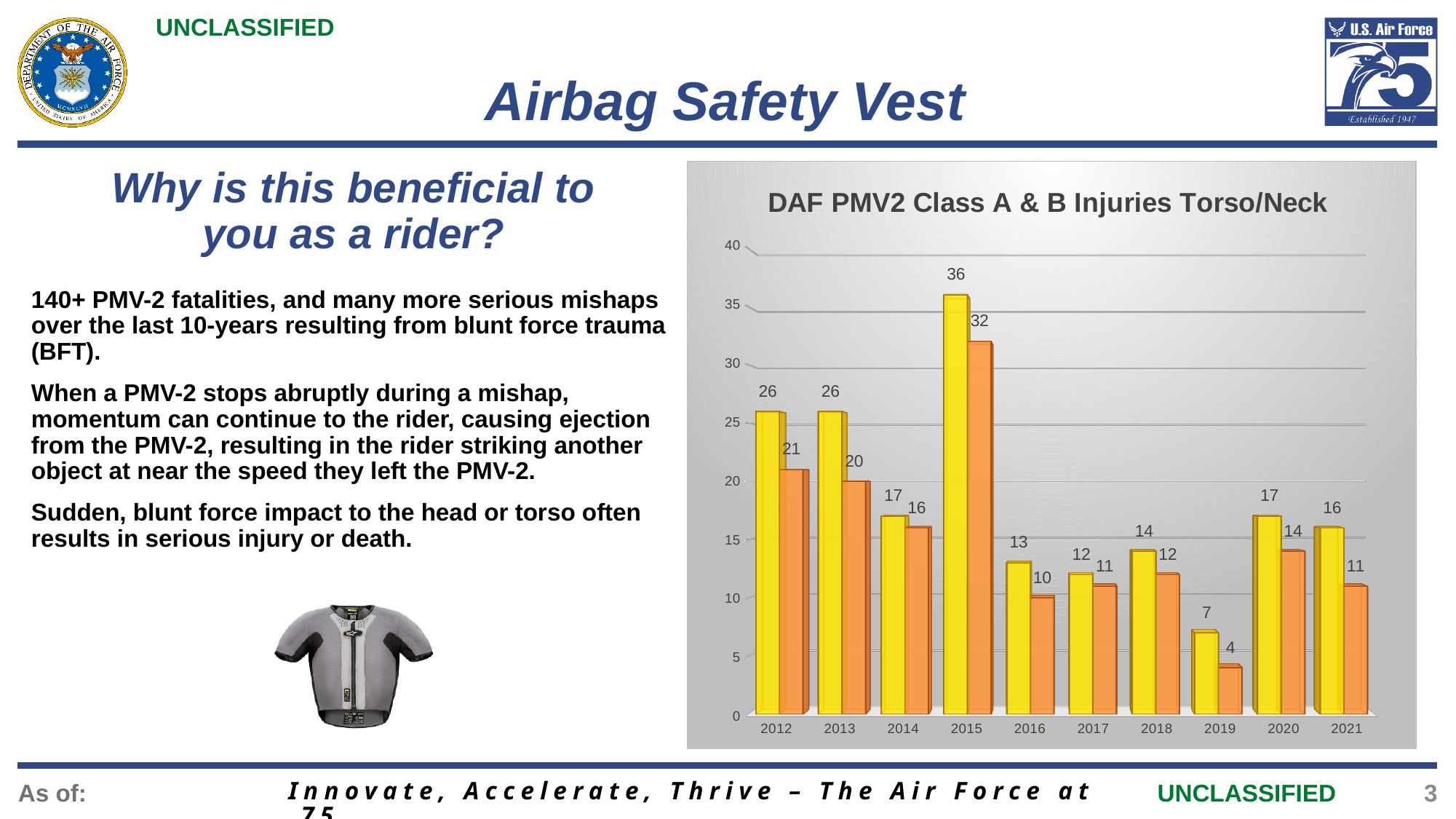
What kind of chart is shown on the slide? bar chart What is the difference between the yellow and orange bars for 2015? 4 How many years are shown on the x axis of the chart? 10 What is the value of the orange bar for 2019? 4 What is the title of the chart? DAF PMV2 Class A & B Injuries Torso/Neck Which year has the highest yellow bar? 2015 Do the yellow bar values generally rise or fall from 2015 to 2019? fall What is the value of the yellow bar for 2015? 36 Is the value of the yellow bar for 2016 greater or less than 15? less Which is larger, the yellow bar for 2020 or the yellow bar for 2021? 2020 Which year has the lowest orange bar? 2019 What is the value of the orange bar for 2021? 11